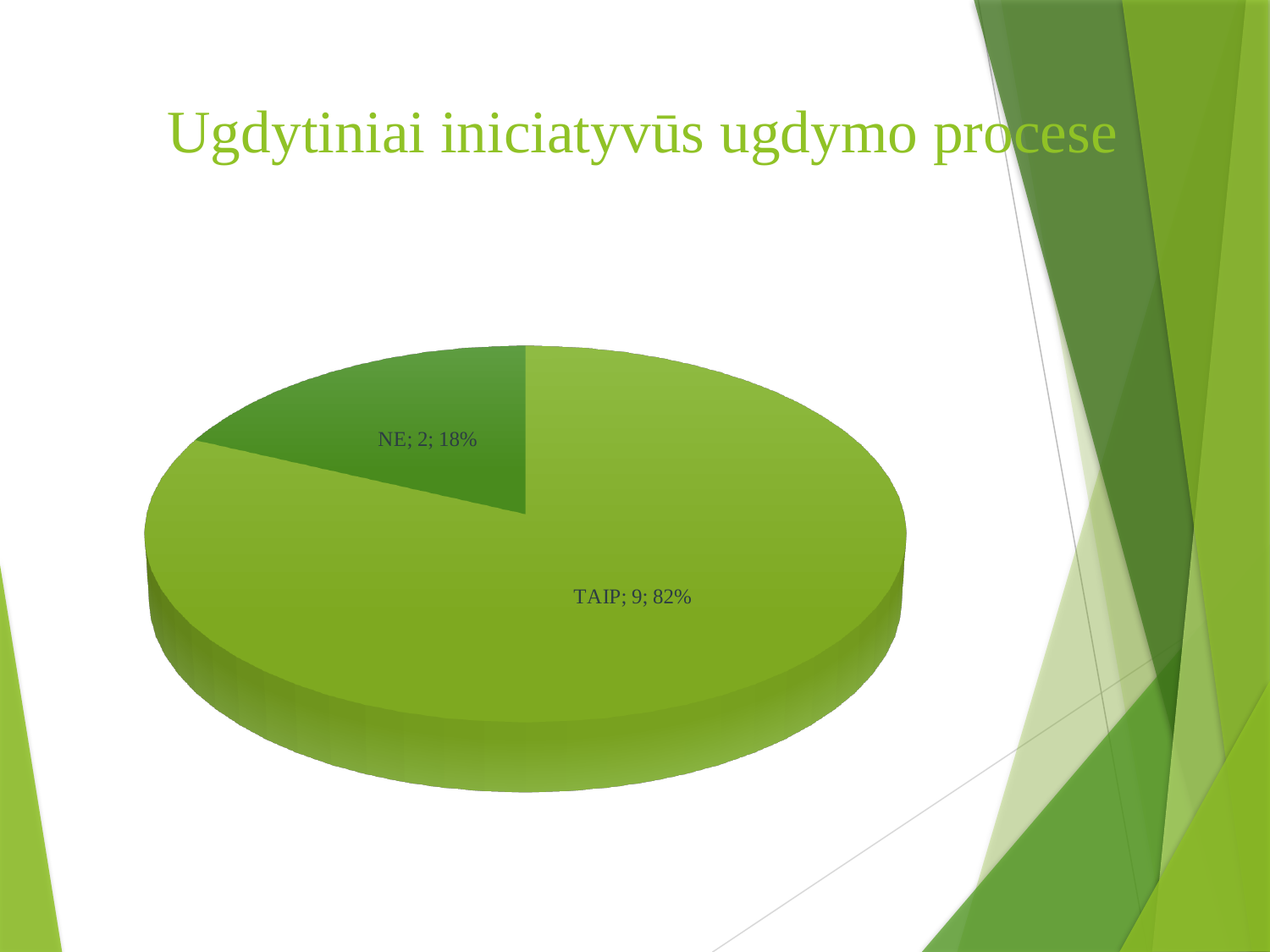
What kind of chart is shown on the slide? pie chart Which category has the largest slice? TAIP What share of the pie does the NE slice represent? 18% What is the value for NE? 2 What is the difference between the values for TAIP and NE? 7 How many slices does the pie chart have? 2 Which is larger, the value for TAIP or the value for NE? TAIP What is the total of the values for TAIP and NE? 11 What is the title of the slide containing the chart? Ugdytiniai iniciatyvūs ugdymo procese What is the value for TAIP? 9 What share of the pie does the TAIP slice represent? 82% Which category has the smallest slice? NE